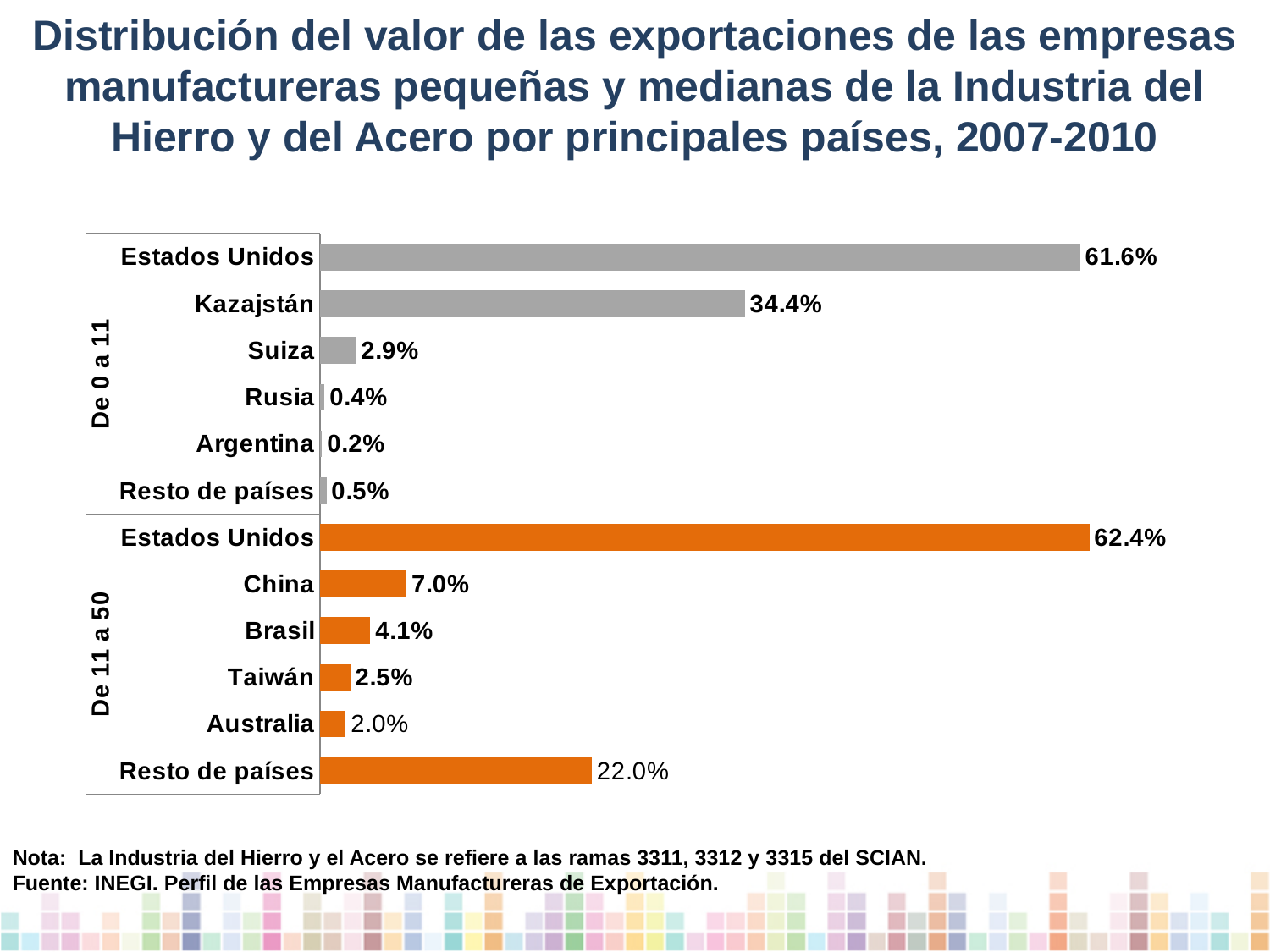
Which category has the highest value in the "De 11 a 50" group? Estados Unidos Which country has the lowest value in the "De 0 a 11" group? Argentina What is the value for Resto de países in the "De 11 a 50" group? 22.0% How many bars are shown in the "De 11 a 50" group? 6 What is the difference between Brasil and Taiwán in the "De 11 a 50" group? 1.6% What is the value for Estados Unidos in the "De 0 a 11" group? 61.6% What is the value for China in the "De 11 a 50" group? 7.0% Which is larger: Suiza in the "De 0 a 11" group or Taiwán in the "De 11 a 50" group? Suiza What is the difference between the Estados Unidos values in the "De 11 a 50" group and the "De 0 a 11" group? 0.8% What colour are the bars for the "De 11 a 50" group? Orange What is the value for Kazajstán in the "De 0 a 11" group? 34.4% What kind of chart is shown on the slide? Bar chart